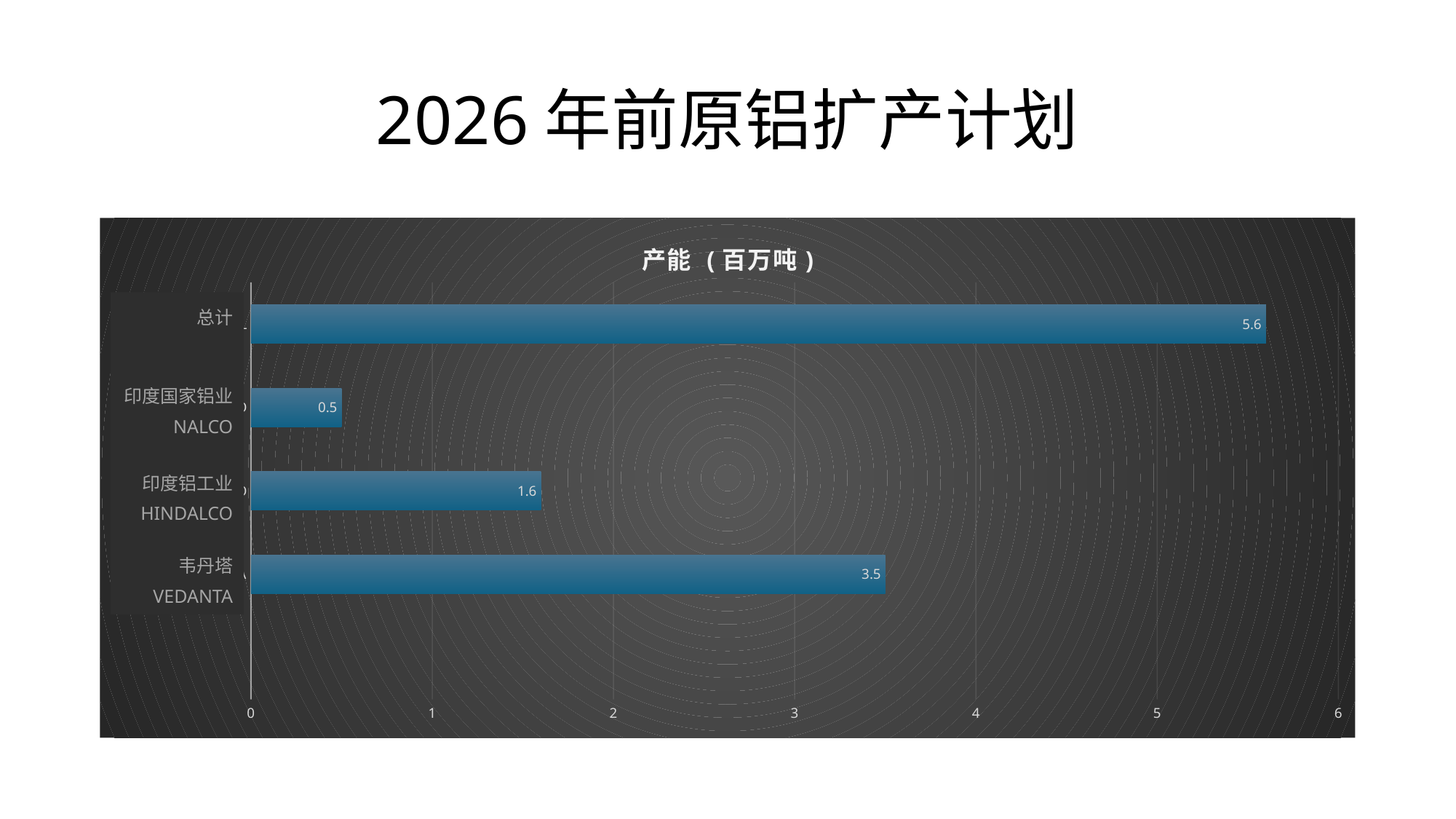
What is the value for 印度国家铝业 NALCO? 0.5 Which category has the lowest value? 印度国家铝业 NALCO Which category has the highest value? 总计 What kind of chart is shown on the slide? bar chart What is the value for 韦丹塔 VEDANTA? 3.5 Which is larger, the value for 印度铝工业 HINDALCO or the value for 印度国家铝业 NALCO? 印度铝工业 HINDALCO What is the value for 印度铝工业 HINDALCO? 1.6 How many categories are shown in the chart? 4 Is the value for 韦丹塔 VEDANTA greater or less than 3? greater What is the difference between the values for 韦丹塔 VEDANTA and 印度铝工业 HINDALCO? 1.9 What is the value for 总计? 5.6 What is the title of the chart? 产能（百万吨）